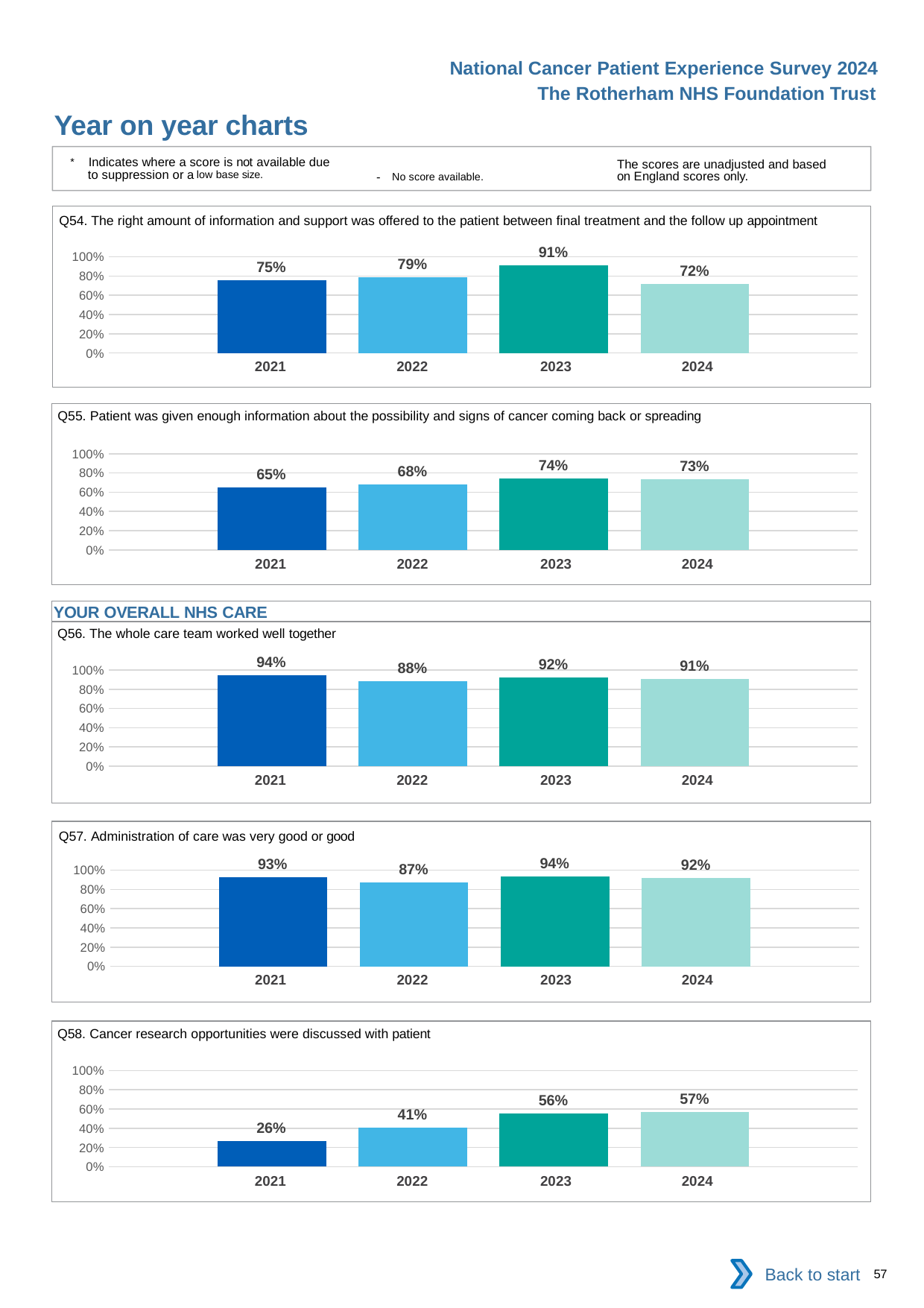
In the Q58 chart, is the value for 2021 greater or less than 40%? less In the Q57 chart, how many years are plotted? 4 In the Q54 chart, which year has the lowest value? 2024 In the Q56 chart, which is larger, the value for 2022 or the value for 2024? 2024 In the Q57 chart, what is the value for 2022? 87% In the Q55 chart, what is the value for 2024? 73% In the Q54 chart, what is the value for 2023? 91% In the Q58 chart, what is the difference between the 2022 and 2021 values? 15 percentage points What kind of chart is the Q54 chart? bar chart In the Q55 chart, what is the difference between the 2023 and 2021 values? 9 percentage points In the Q56 chart, which year has the highest value? 2021 In the Q58 chart, do the values rise or fall from 2021 to 2024? rise